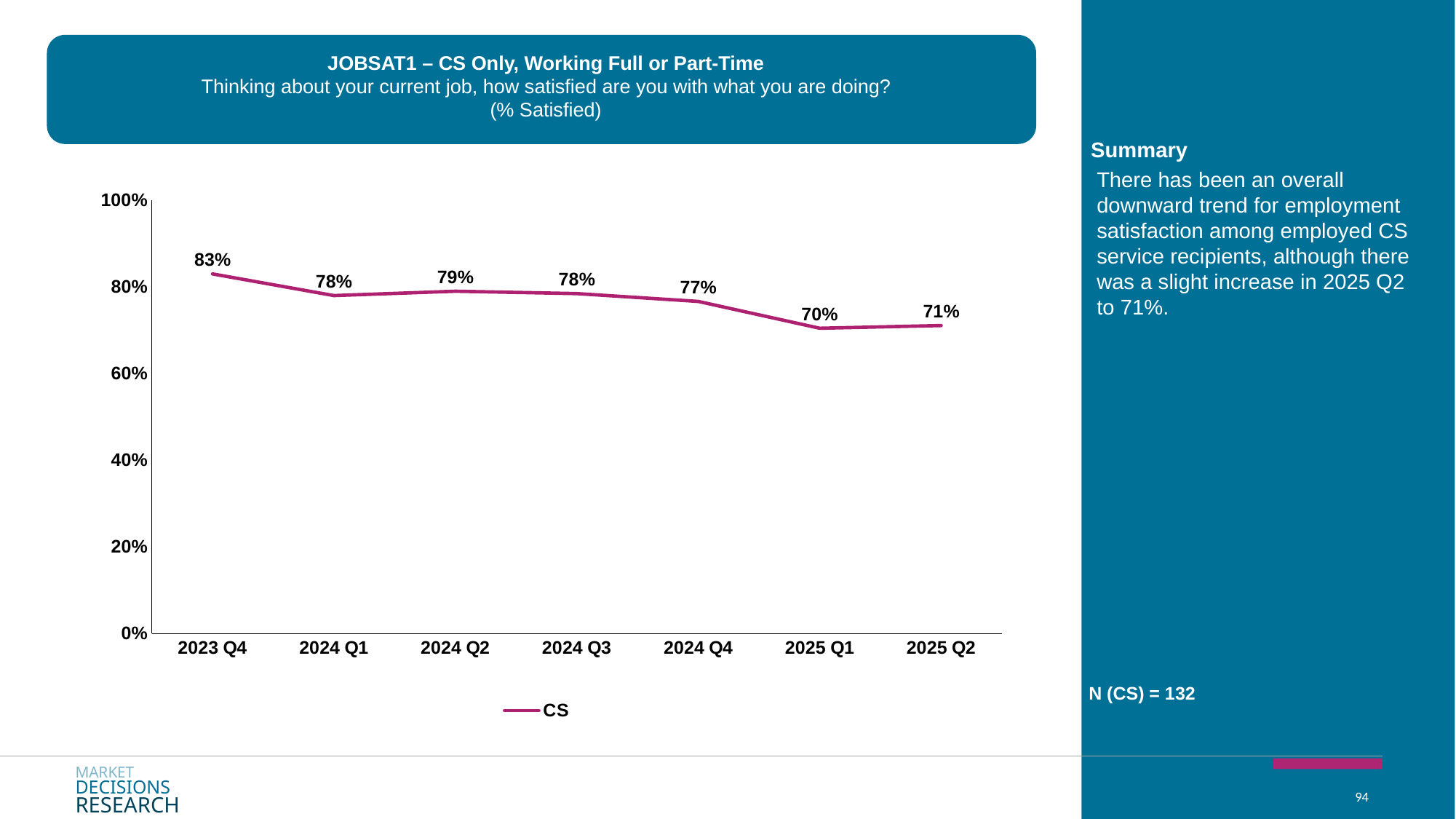
Which quarter has the highest value? 2023 Q4 Is the value for 2025 Q2 greater or less than 80%? less Which is larger, the value for 2024 Q2 or the value for 2025 Q2? 2024 Q2 What is the value for 2024 Q4? 77% How many series does the legend list? 1 What kind of chart is shown? line chart What is the value for 2023 Q4? 83% How many quarters are plotted on the x axis? 7 Do the values generally rise or fall from 2023 Q4 to 2025 Q2? fall What is the difference between the values for 2023 Q4 and 2025 Q1? 13% What is the value for 2025 Q1? 70% Which quarter has the lowest value? 2025 Q1